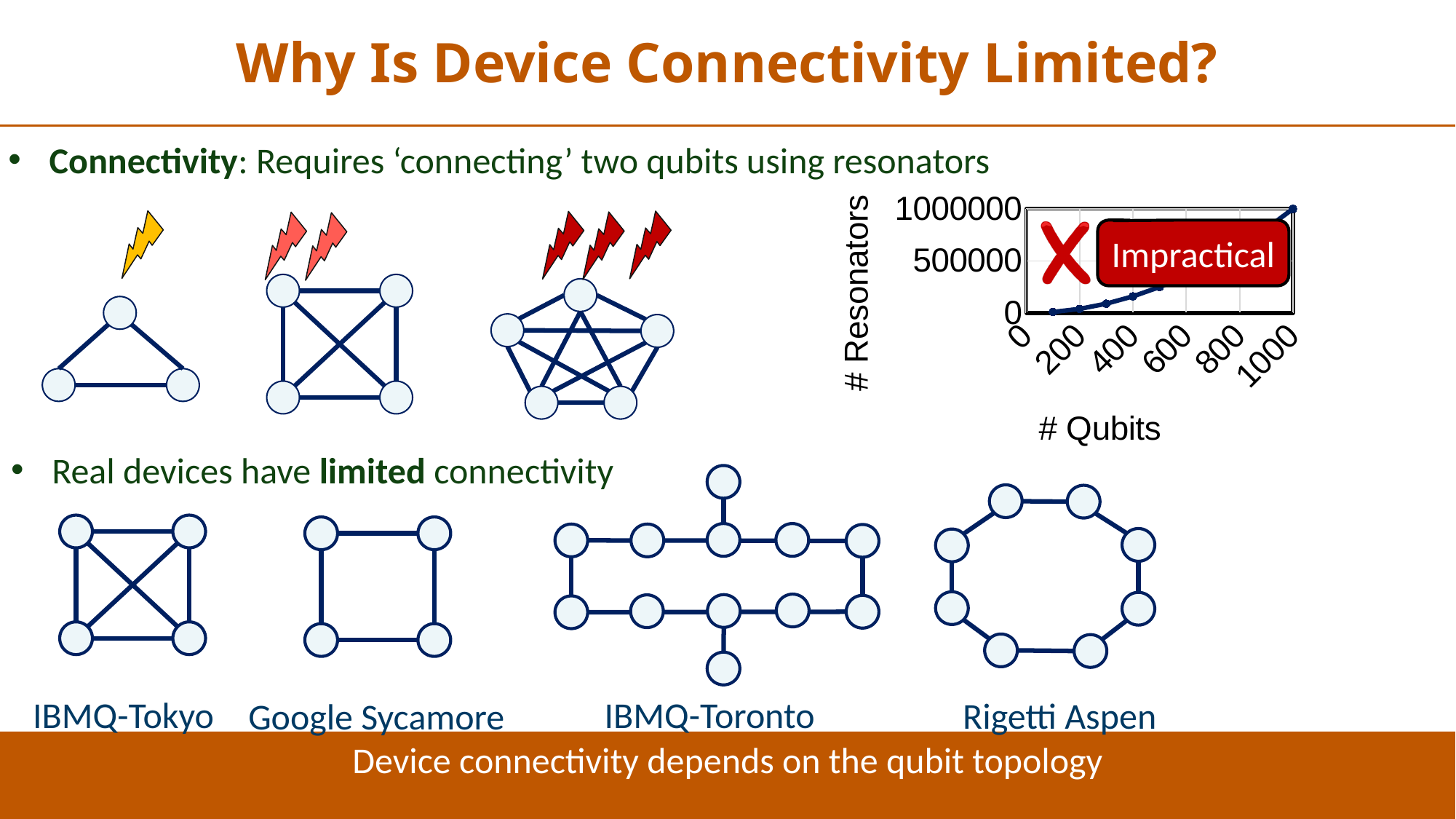
Which has more resonators in the chart, 200 qubits or 1000 qubits? 1000 qubits Is the number of resonators at 1000 qubits greater or less than 500000? greater What is the label of the y axis of the chart? # Resonators What is the highest tick value shown on the y axis of the chart? 1000000 Do the values in the chart rise or fall as the number of qubits increases? rise Is the number of resonators at 200 qubits greater or less than 500000? less Is the number of resonators at 400 qubits greater or less than 500000? less What kind of chart is shown on the slide? line chart What is the label of the x axis of the chart? # Qubits